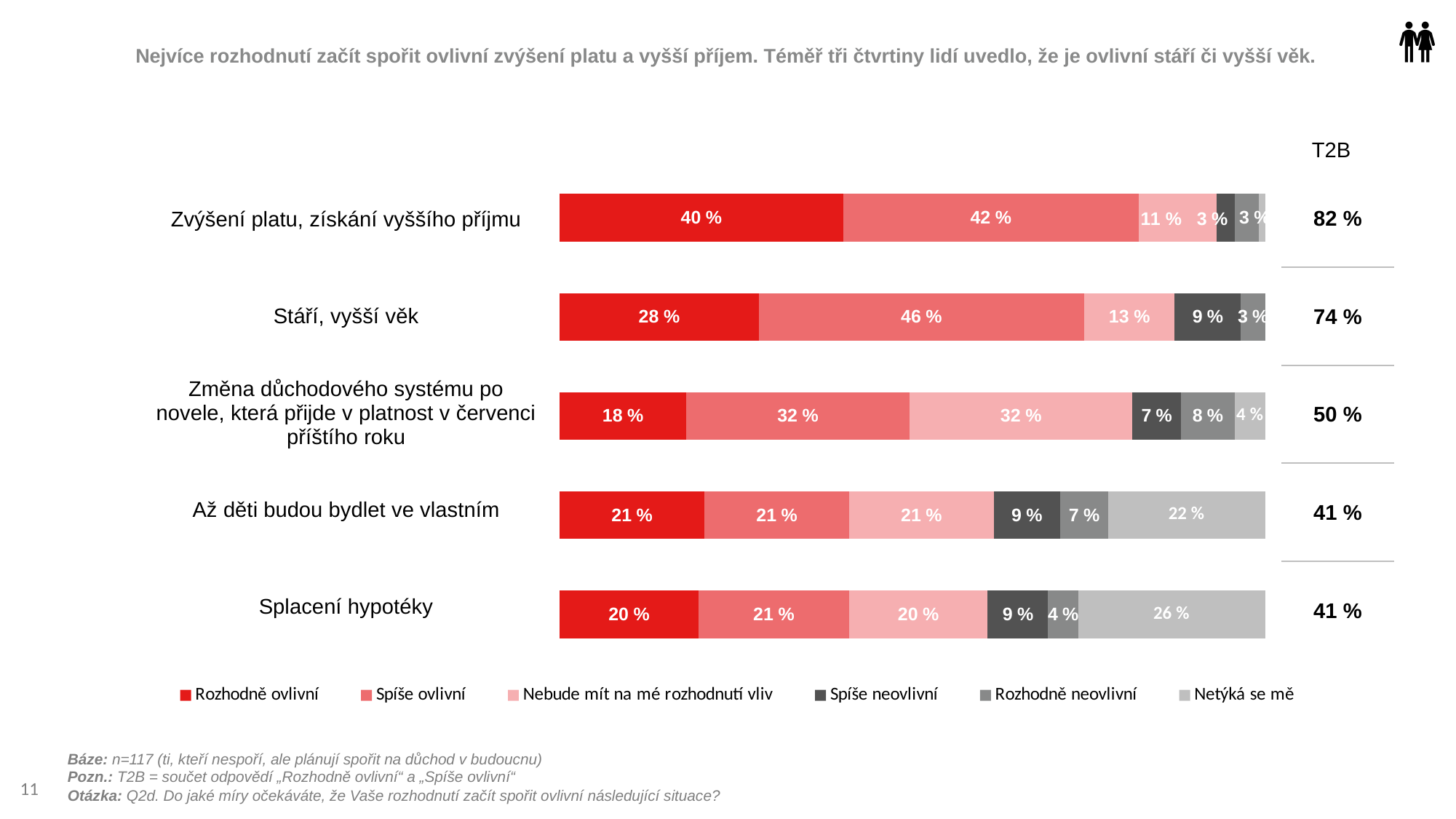
How many series does the legend list? 6 How many categories (bars) are shown in the chart? 5 What is the value of "Rozhodně ovlivní" for "Zvýšení platu, získání vyššího příjmu"? 40 % Which has the larger "Netýká se mě" value: "Splacení hypotéky" or "Až děti budou bydlet ve vlastním"? Splacení hypotéky Which category has the lowest "Rozhodně ovlivní" value? Změna důchodového systému po novele, která přijde v platnost v červenci příštího roku Which category has the highest "Rozhodně ovlivní" value? Zvýšení platu, získání vyššího příjmu Which legend entry is shown in the darkest red colour? Rozhodně ovlivní What is the difference between the T2B values for "Zvýšení platu, získání vyššího příjmu" and "Stáří, vyšší věk"? 8 % What is the value of "Netýká se mě" for "Splacení hypotéky"? 26 % What is the T2B value for "Změna důchodového systému po novele, která přijde v platnost v červenci příštího roku"? 50 % What kind of chart is shown on the slide? Stacked bar chart What is the value of "Spíše ovlivní" for "Stáří, vyšší věk"? 46 %